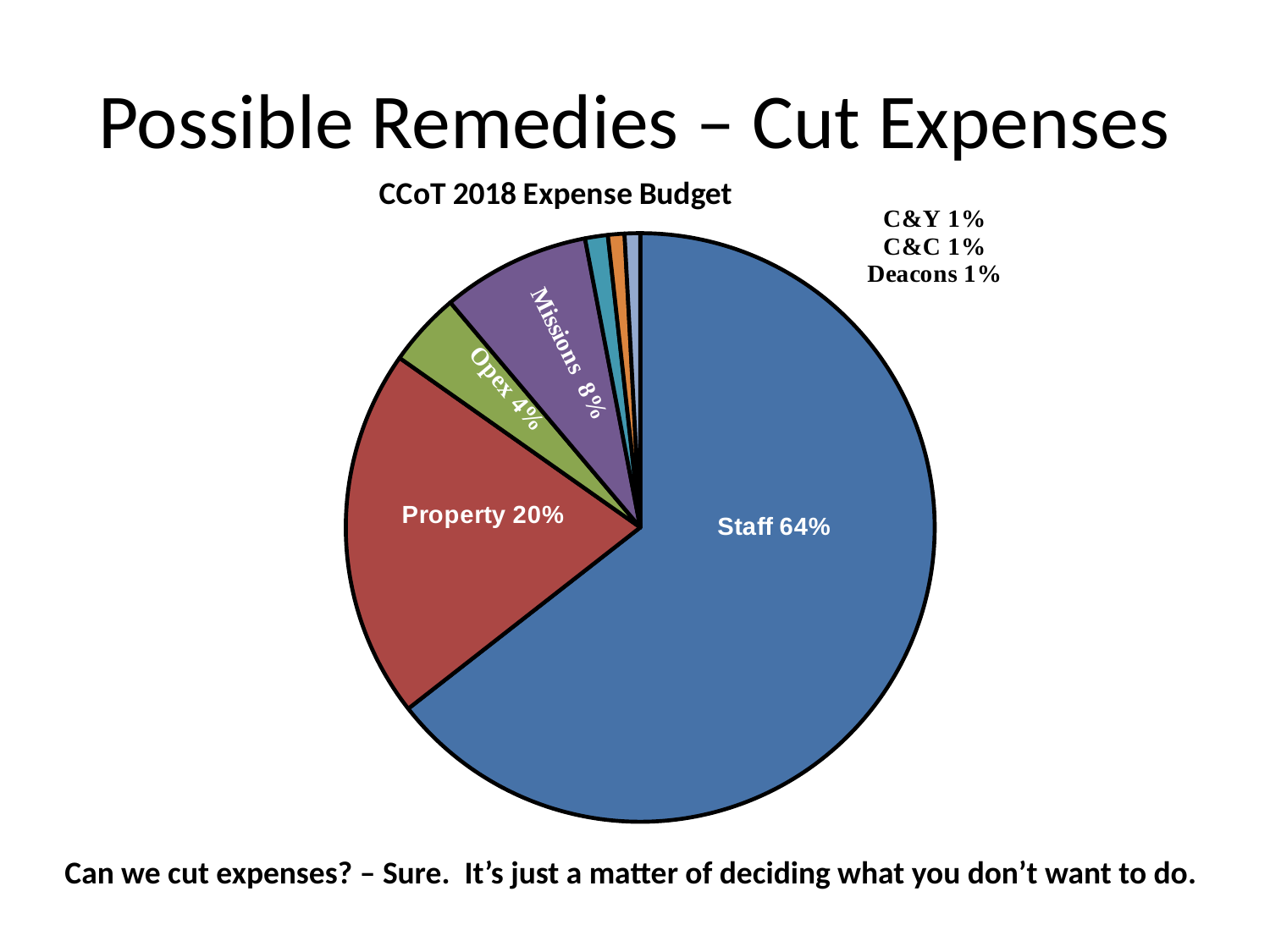
What percentage of the expense budget is Missions? 8% What kind of chart is shown on the slide? Pie chart Which is larger, the Missions share or the Opex share? Missions What percentage of the expense budget is Opex? 4% How many slices does the pie chart have? 7 What percentage of the expense budget is Property? 20% What is the title of the chart? CCoT 2018 Expense Budget What colour is the Property slice? Red What is the difference in percentage points between the Staff and Property shares? 44 What percentage of the expense budget is Deacons? 1% Which category takes the largest share of the expense budget? Staff What share of the CCoT 2018 Expense Budget goes to Staff? 64%